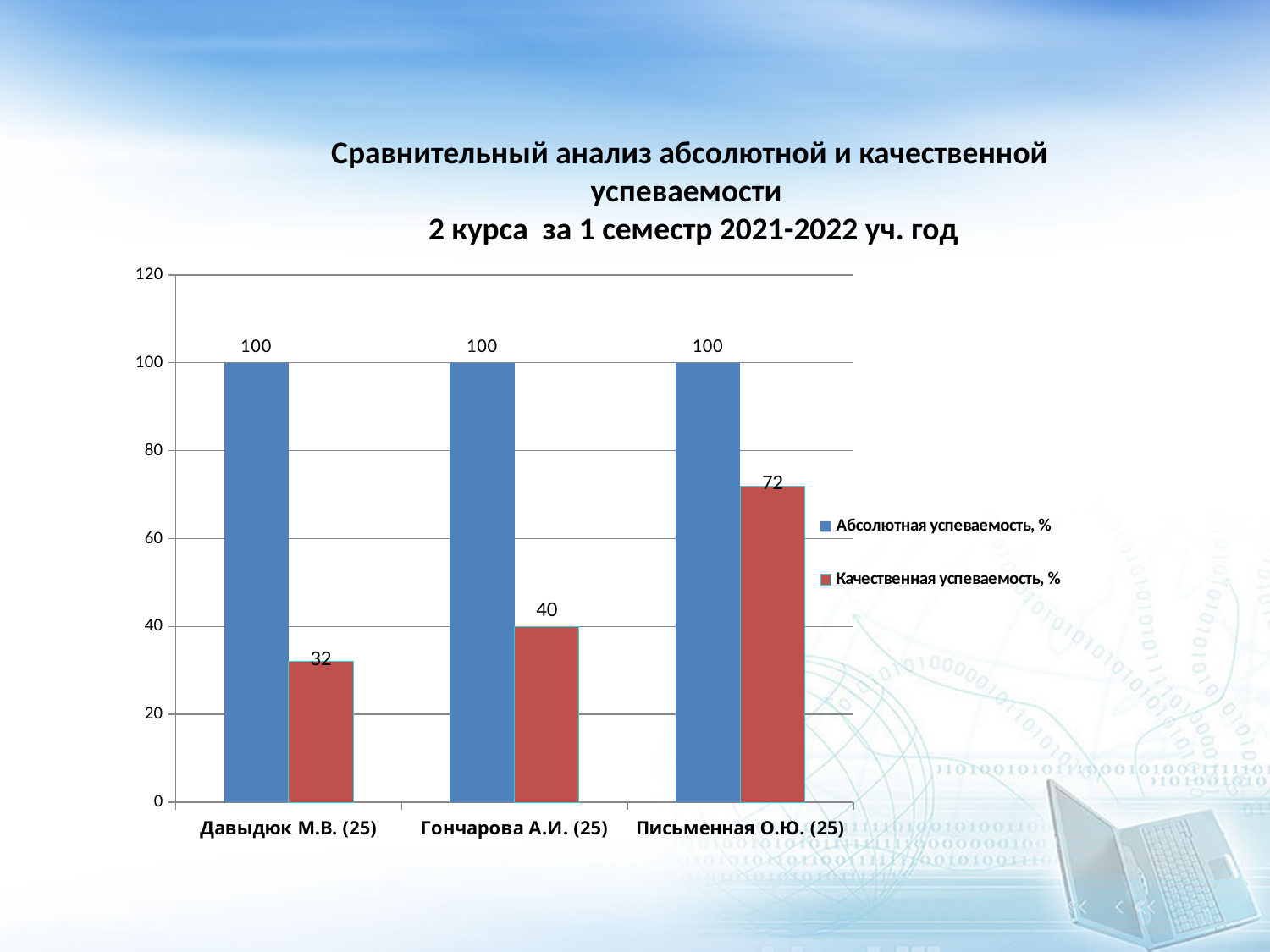
What kind of chart is shown on the slide? Bar chart Which category has the lowest Качественная успеваемость, %? Давыдюк М.В. (25) Which is larger: Качественная успеваемость, % for Гончарова А.И. (25) or for Давыдюк М.В. (25)? Гончарова А.И. (25) What is the difference between Качественная успеваемость, % for Письменная О.Ю. (25) and Давыдюк М.В. (25)? 40 What is the value of Качественная успеваемость, % for Давыдюк М.В. (25)? 32 How many categories are shown on the x axis? 3 How many series does the legend list? 2 What is the value of Качественная успеваемость, % for Письменная О.Ю. (25)? 72 Which category has the highest Качественная успеваемость, %? Письменная О.Ю. (25) What is the value of Абсолютная успеваемость, % for Гончарова А.И. (25)? 100 Does Качественная успеваемость, % rise or fall from left to right across the categories? Rise What is the value of Качественная успеваемость, % for Гончарова А.И. (25)? 40